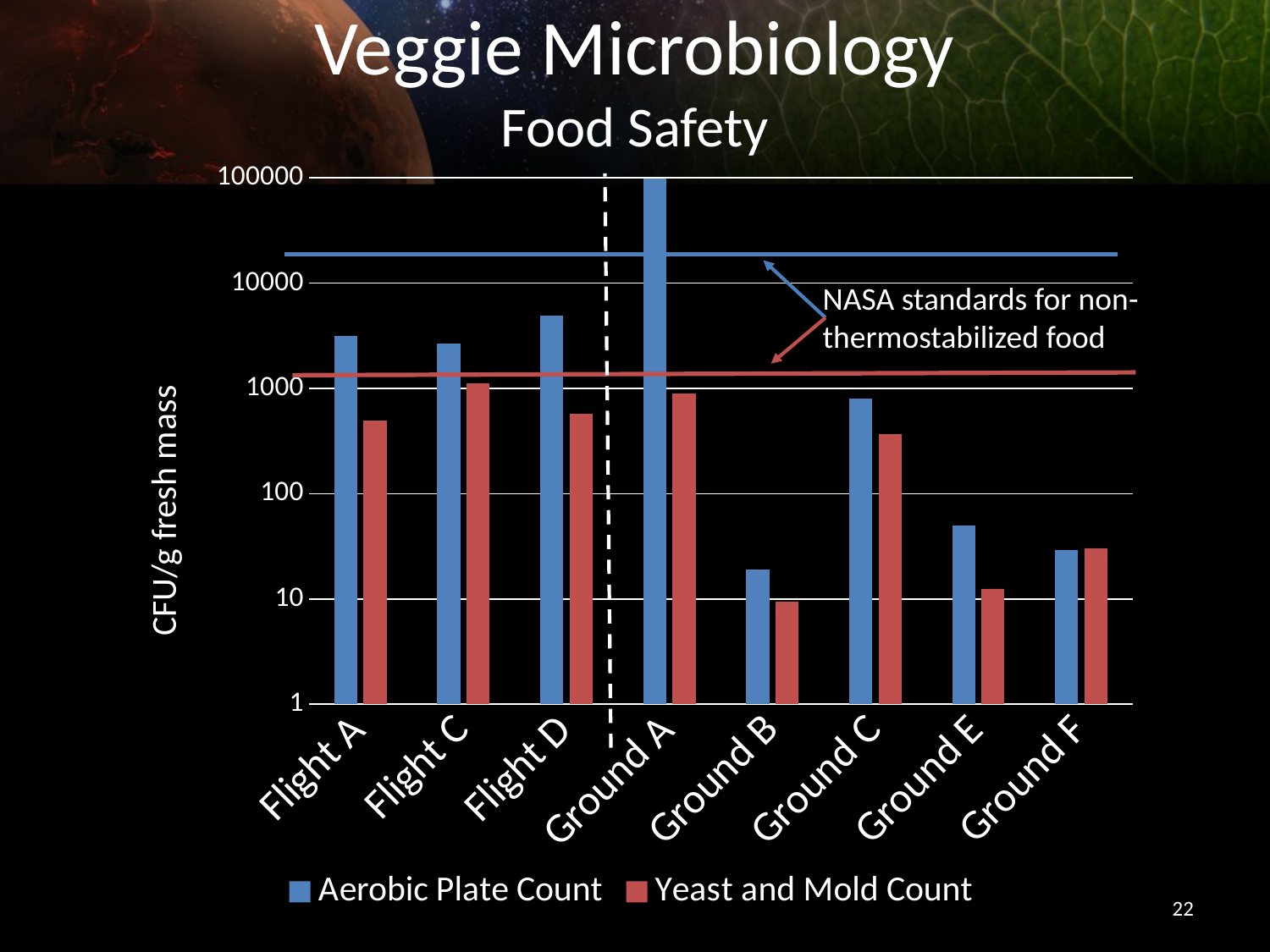
What do the horizontal blue and red lines across the chart represent, according to the annotation? NASA standards for non-thermostabilized food How many series does the chart legend list? 2 Is the Aerobic Plate Count for Flight A greater or less than 1000? greater Which category has the lowest Yeast and Mold Count? Ground B Is the Yeast and Mold Count for Flight A greater or less than 1000? less Is the Aerobic Plate Count for Flight D greater or less than 10000? less How many categories are shown on the x axis of the chart? 8 For Flight C, which is larger: the Aerobic Plate Count or the Yeast and Mold Count? Aerobic Plate Count Which category has the highest Aerobic Plate Count? Ground A What is the label on the vertical axis of the chart? CFU/g fresh mass What kind of chart is shown on the slide? bar chart